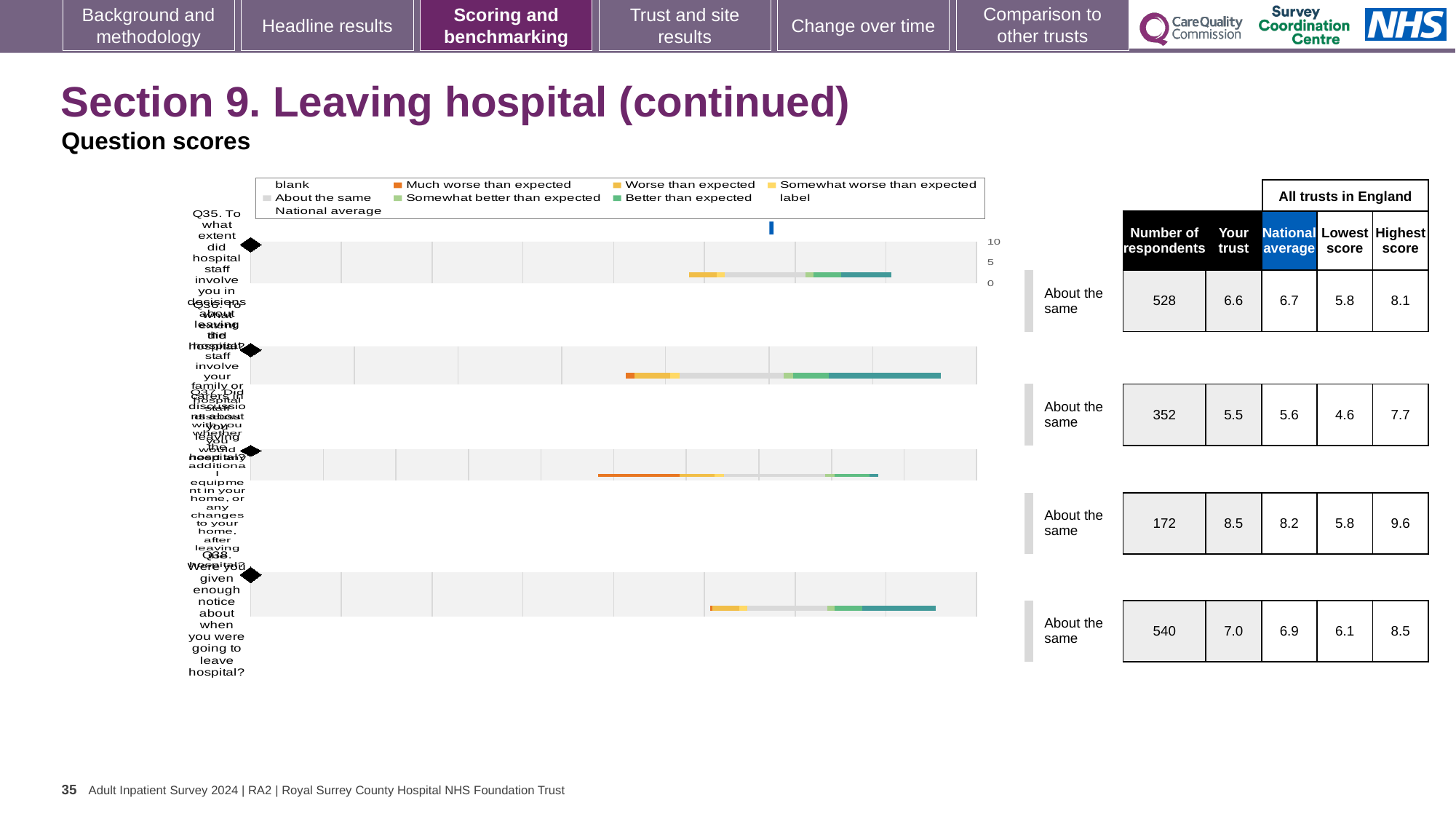
What kind of chart is shown on the slide? bar chart What benchmark category is shown next to each bar in the chart? About the same Which colour does the legend use for 'Much worse than expected'? orange How many respondents answered Q37 (discussing additional equipment or changes to your home)? 172 What is the 'Your trust' score for Q35 (involving you in decisions about leaving hospital)? 6.6 Which question has the lowest 'Your trust' score? Q36 What is the difference between the highest score and the lowest score for Q37? 3.8 Which question has the highest 'Your trust' score? Q37 For Q38 (enough notice about leaving hospital), which is larger: the 'Your trust' score or the national average? Your trust What is the highest score among all trusts in England for Q38? 8.5 How many questions (bars) are plotted in the chart? 4 What is the national average score for Q36 (involving family or carers in decisions about leaving hospital)? 5.6